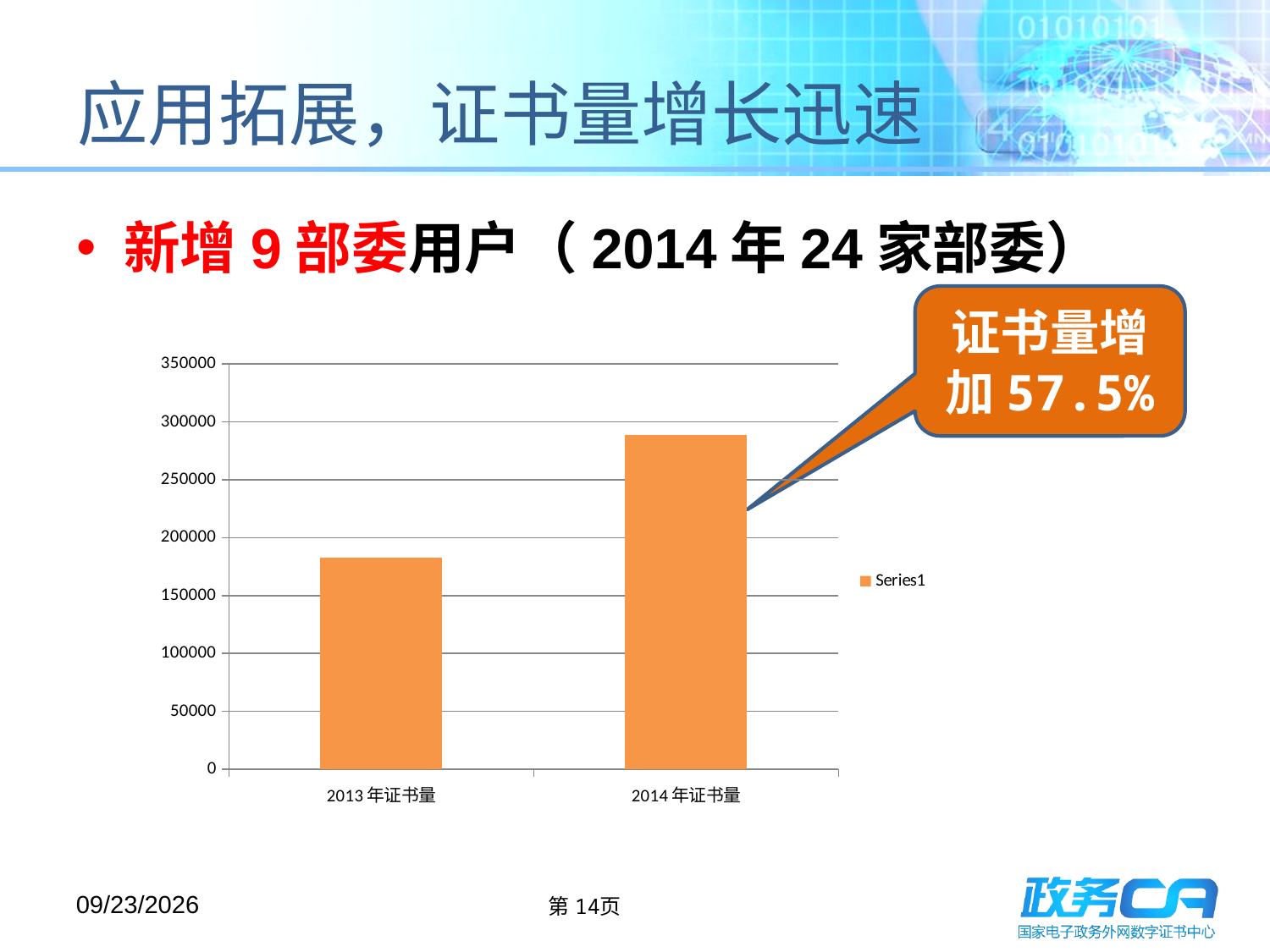
What kind of chart is shown on the slide? bar chart How many categories are plotted on the x axis of the chart? 2 Which category has the lowest value in the chart? 2013年证书量 Which category has the highest value in the chart? 2014年证书量 Is the value for 2013年证书量 greater or less than 200000? less Is the value for 2013年证书量 greater or less than 150000? greater What is the name of the series shown in the chart legend? Series1 Do the values rise or fall from 2013年证书量 to 2014年证书量? rise Is the value for 2014年证书量 greater or less than 250000? greater How many series does the chart legend list? 1 Which is larger, the value for 2013年证书量 or the value for 2014年证书量? 2014年证书量